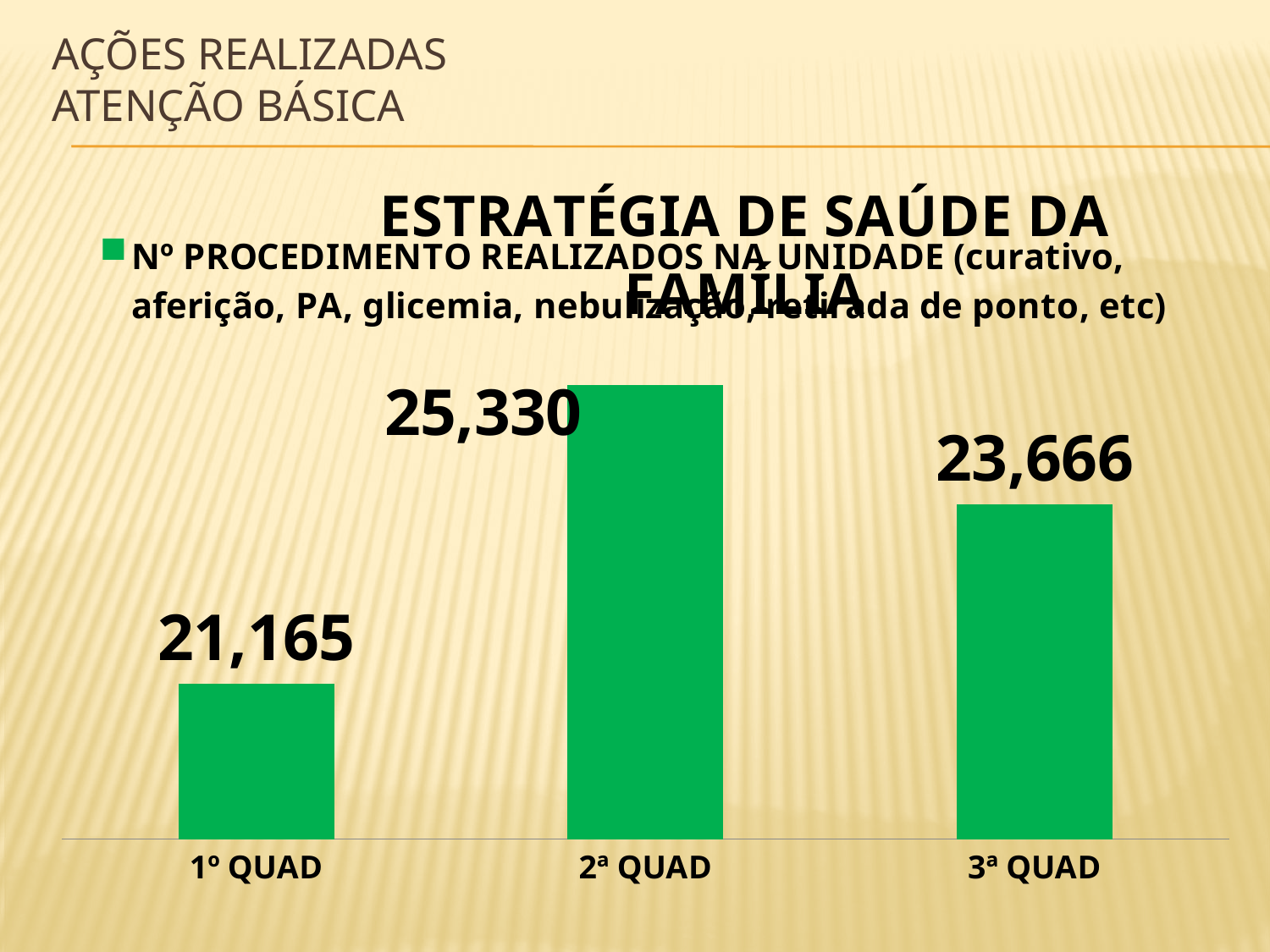
What colour are the bars in the chart? Green What is the difference between the values for 2ª QUAD and 1º QUAD? 4,165 Which is larger, the value for 3ª QUAD or the value for 1º QUAD? 3ª QUAD Which category has the highest value? 2ª QUAD What is the value for 2ª QUAD? 25,330 Which category has the lowest value? 1º QUAD What is the difference between the values for 3ª QUAD and 1º QUAD? 2,501 What is the value for 1º QUAD? 21,165 What kind of chart is shown on the slide? Bar chart Does the value rise or fall from 2ª QUAD to 3ª QUAD? Fall How many categories are shown on the x axis? 3 What is the value for 3ª QUAD? 23,666